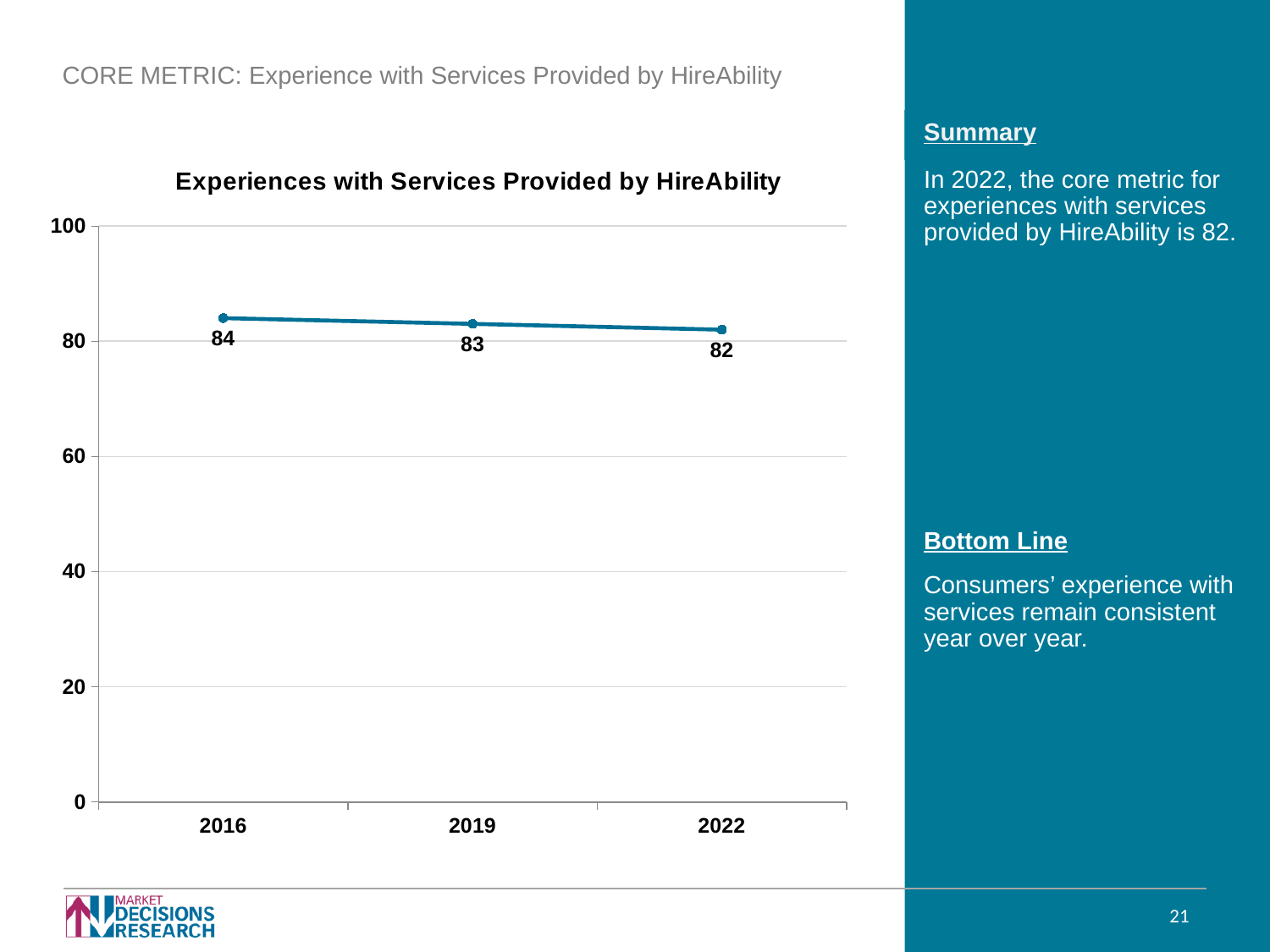
Which year has the highest value? 2016 What is the value for 2022? 82 What is the value for 2019? 83 Is the value for 2022 greater or less than 80? greater How many years are plotted on the chart? 3 Which year has the lowest value? 2022 What kind of chart is shown? line chart What is the difference between the values for 2016 and 2022? 2 What is the title of the chart? Experiences with Services Provided by HireAbility Do the values rise or fall from 2016 to 2022? fall What is the value for 2016? 84 Which is larger, the value for 2016 or the value for 2019? 2016